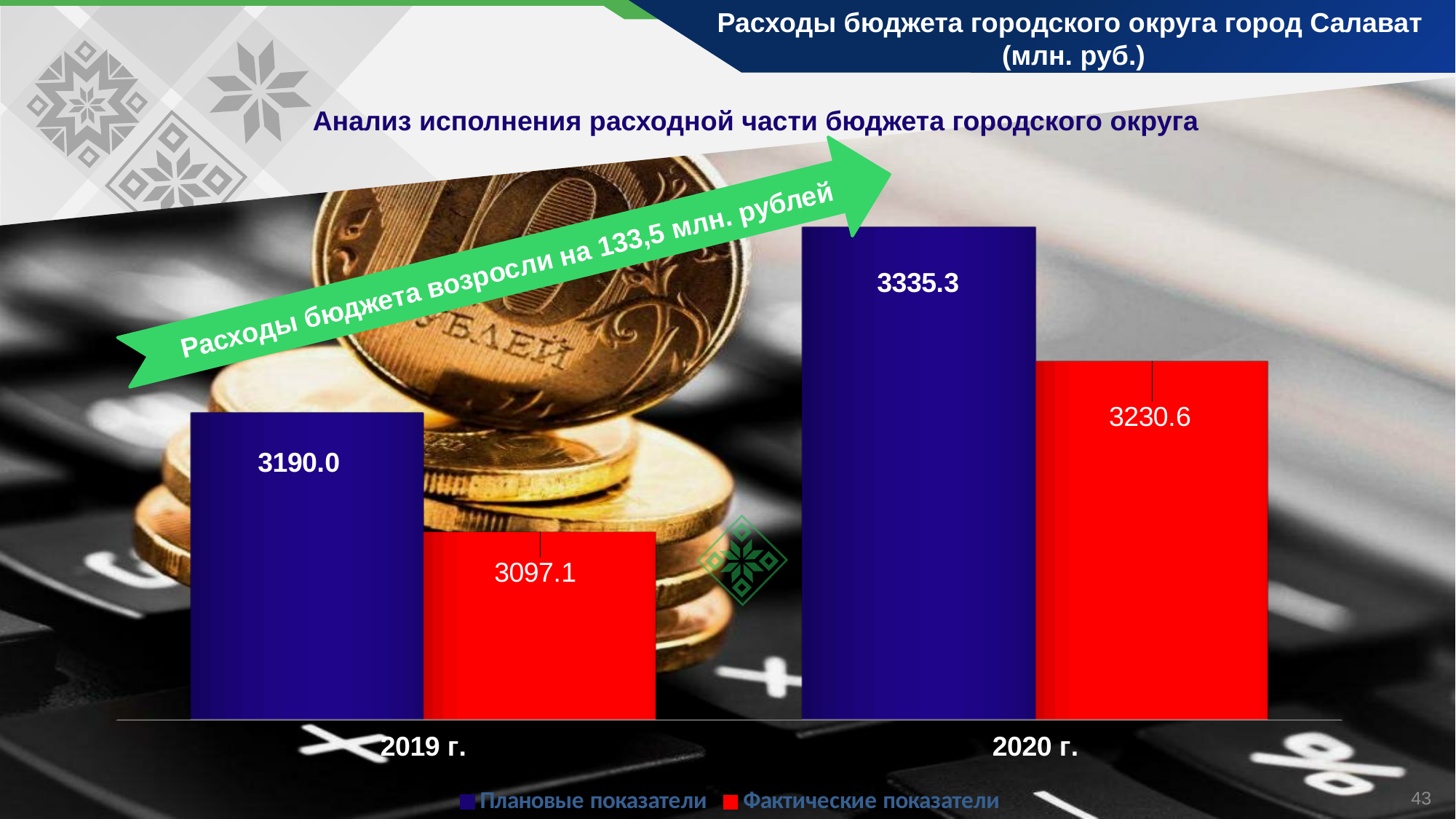
What is the value of Плановые показатели for 2019 г.? 3190.0 Which bar has the lowest value on the chart? Фактические показатели, 2019 г. What is the value of Фактические показатели for 2019 г.? 3097.1 By how much did Фактические показатели increase from 2019 г. to 2020 г.? 133.5 What type of chart is shown on the slide? Bar chart What is the difference between Плановые показатели and Фактические показатели for 2020 г.? 104.7 What is the value of Фактические показатели for 2020 г.? 3230.6 Which is larger for 2019 г.: Плановые показатели or Фактические показатели? Плановые показатели Which bar has the highest value on the chart? Плановые показатели, 2020 г. How many categories are shown on the x axis? 2 What is the value of Плановые показатели for 2020 г.? 3335.3 How many series does the legend list? 2